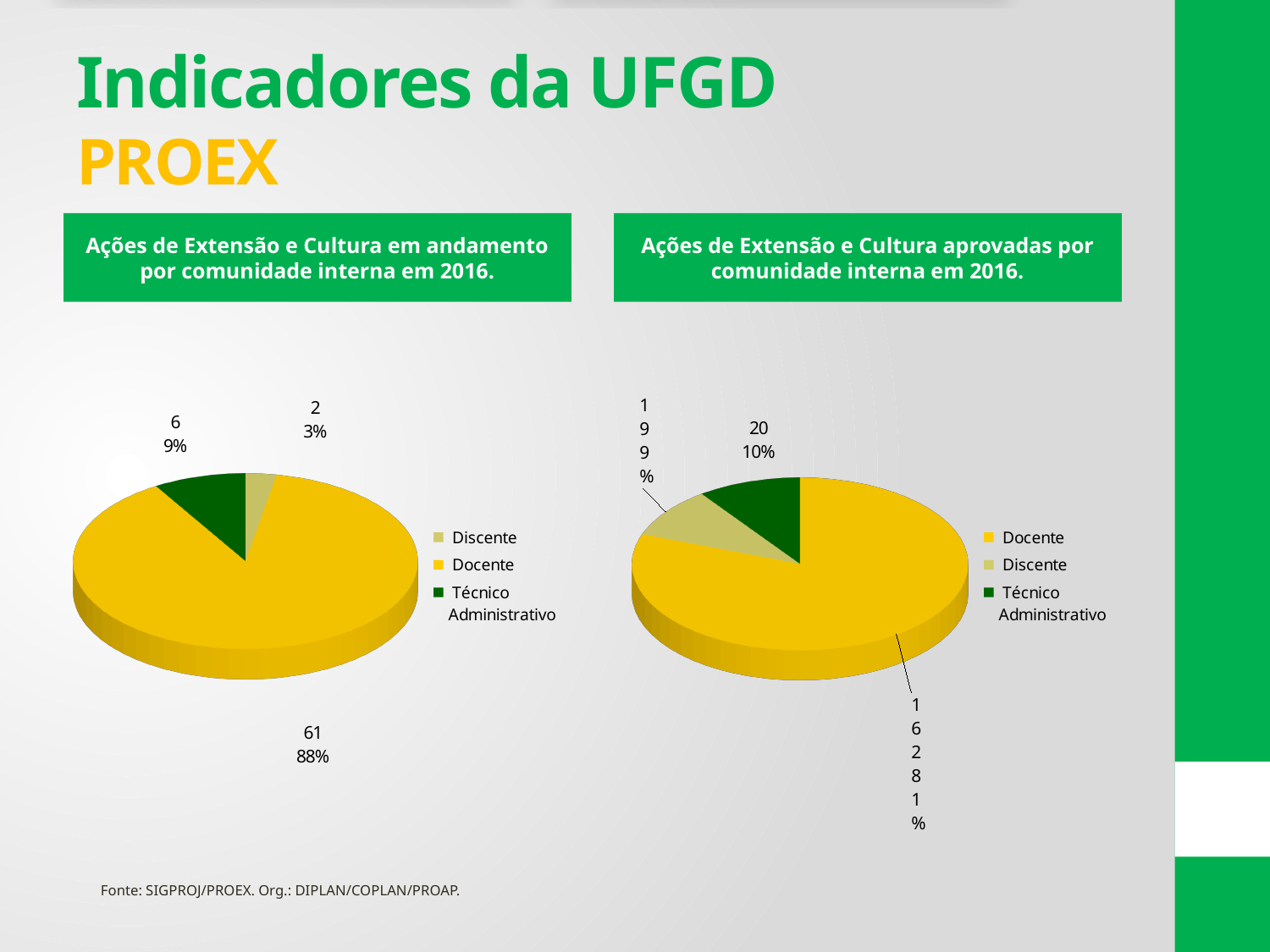
What type of chart is used on the left side of the slide? Pie chart In the right chart (Ações de Extensão e Cultura aprovadas), what percentage share does Docente have? 81% In the right chart (Ações de Extensão e Cultura aprovadas), which is larger, the value for Técnico Administrativo or the value for Discente? Técnico Administrativo In the left chart (Ações de Extensão e Cultura em andamento), what is the total of all three categories? 69 In the left chart (Ações de Extensão e Cultura em andamento), which category has the smallest slice? Discente In the left chart (Ações de Extensão e Cultura em andamento), what is the difference between the Docente and Técnico Administrativo values? 55 In the right chart (Ações de Extensão e Cultura aprovadas), what is the value for Discente? 19 In the right chart (Ações de Extensão e Cultura aprovadas), which category has the largest slice? Docente In the right chart (Ações de Extensão e Cultura aprovadas), what is the value for Docente? 162 How many categories does the legend of the right chart (Ações de Extensão e Cultura aprovadas) list? 3 In the left chart (Ações de Extensão e Cultura em andamento), what percentage share does Técnico Administrativo have? 9% In the left chart (Ações de Extensão e Cultura em andamento), what is the value for Docente? 61